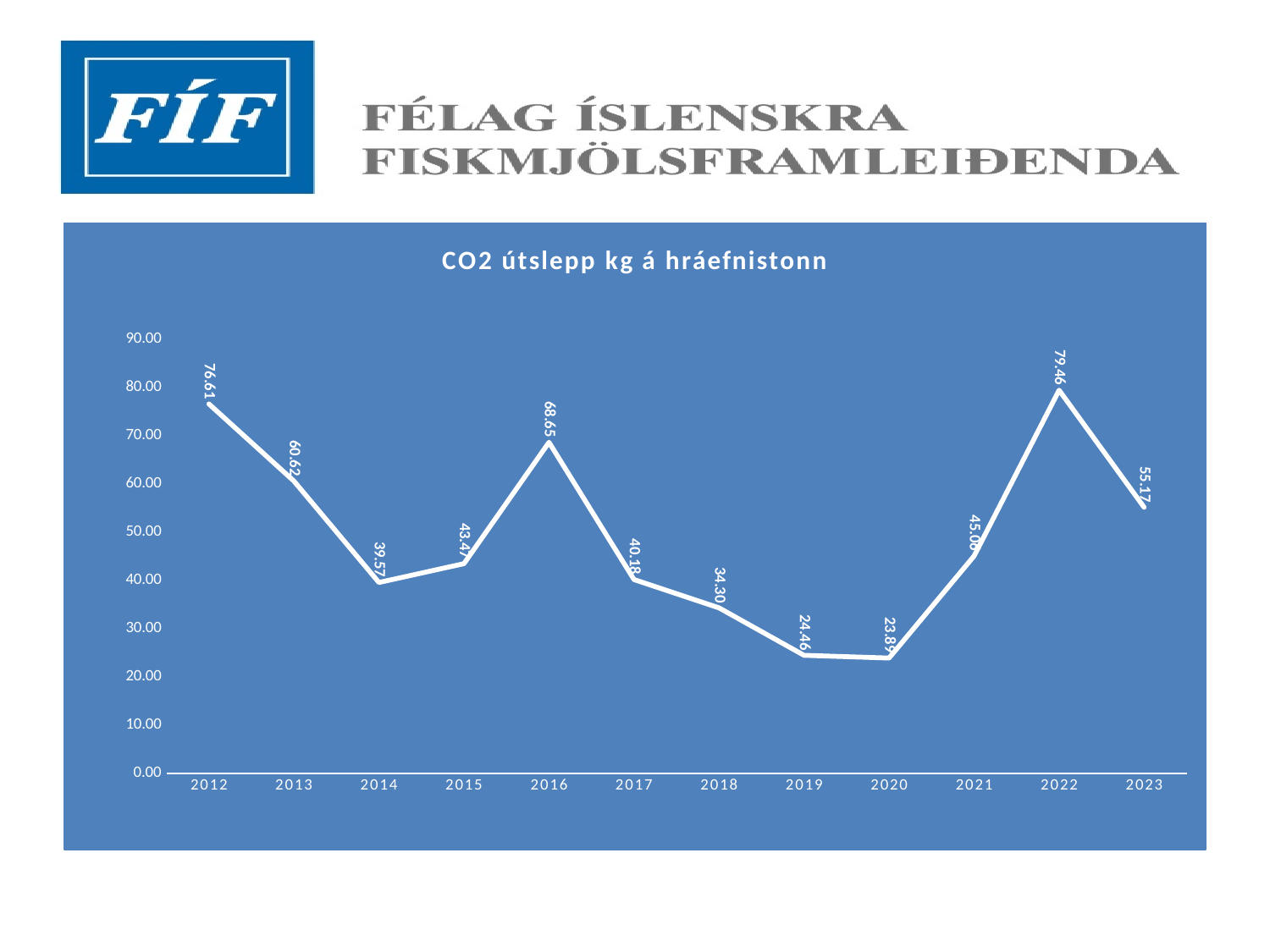
Which is larger, the value for 2014 or the value for 2015? 2015 What is the difference between the values for 2022 and 2023? 24.29 Which year has the highest value? 2022 What is the value for 2016? 68.65 What is the value for 2020? 23.89 What is the value for 2012? 76.61 What is the value for 2023? 55.17 What kind of chart is shown? Line chart What is the difference between the values for 2012 and 2013? 15.99 Which year has the lowest value? 2020 How many years are plotted on the chart? 12 What is the title of the chart? CO2 útslepp kg á hráefnistonn